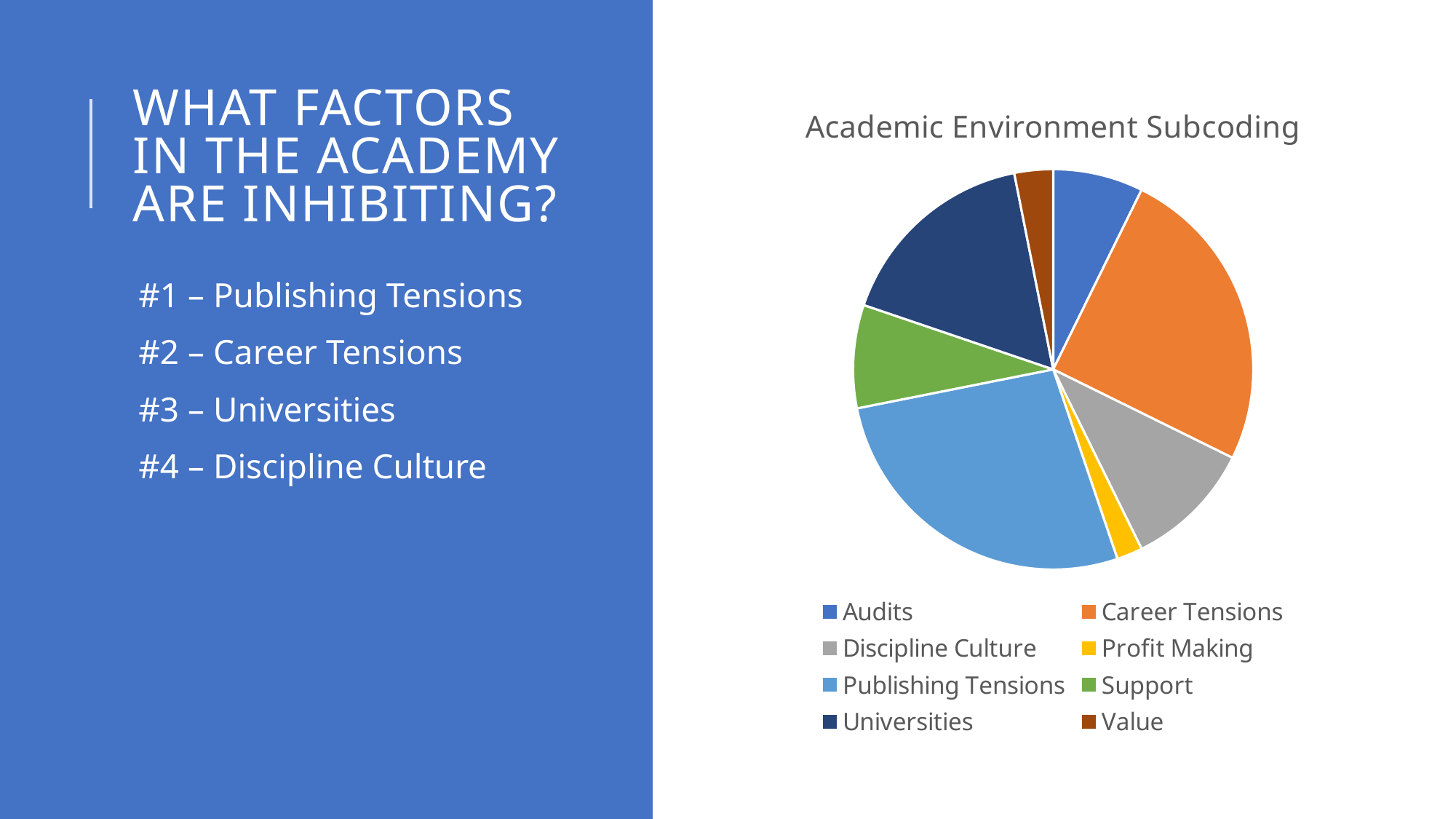
How many categories does the pie chart's legend list? 8 What kind of chart is shown on the slide? pie chart Which slice is larger, Audits or Value? Audits Which category has the largest slice of the pie? Publishing Tensions What is the title of the chart? Academic Environment Subcoding Which slice is larger, Support or Profit Making? Support What colour is the Profit Making slice in the pie chart? yellow Which slice is larger, Universities or Support? Universities Which category has the smallest slice of the pie? Profit Making